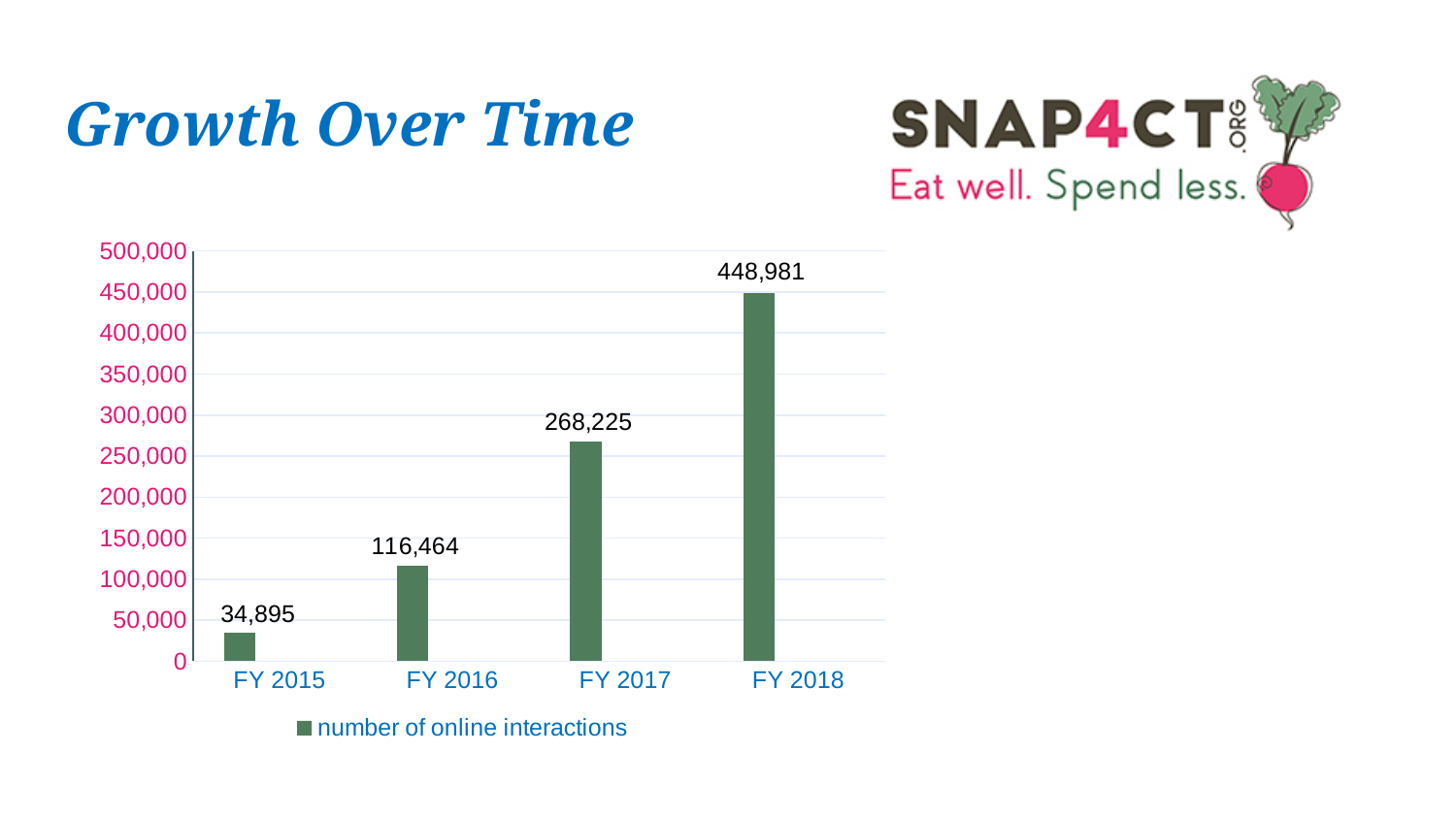
Which fiscal year has the lowest number of online interactions? FY 2015 What is the number of online interactions for FY 2015? 34,895 Is the value for FY 2016 greater or less than 100,000? greater Which fiscal year has the highest number of online interactions? FY 2018 What is the number of online interactions for FY 2017? 268,225 How many fiscal years are shown on the chart? 4 Which has more online interactions, FY 2016 or FY 2017? FY 2017 What is the difference in online interactions between FY 2016 and FY 2015? 81,569 What is the number of online interactions for FY 2018? 448,981 What kind of chart is shown on the slide? bar chart Do the values rise or fall from FY 2015 to FY 2018? rise What is the difference in online interactions between FY 2018 and FY 2017? 180,756